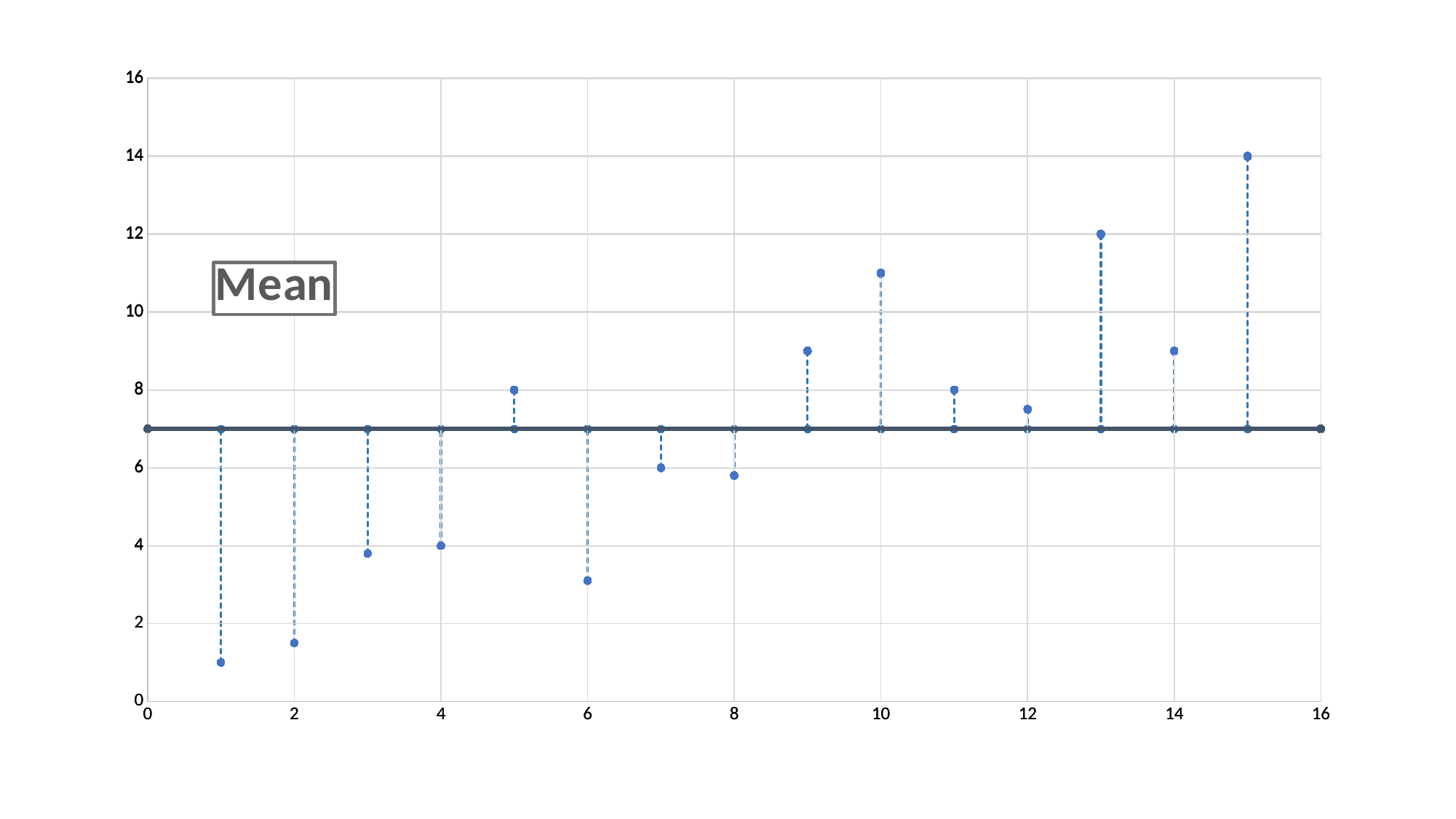
What is the y value of the point at x = 15? 14 What does the horizontal line across the chart represent, according to the label on the slide? Mean Is the y value of the point at x = 6 greater or less than 4? less What is the difference between the y values at x = 15 and x = 13? 2 Which point has the larger y value, the one at x = 13 or the one at x = 10? x = 13 What type of chart is shown on the slide? scatter chart What is the y value of the point at x = 13? 12 What is the y value of the point at x = 4? 4 What is the y value of the point at x = 5? 8 How many data points are plotted above the x axis (excluding the mean line)? 15 Do the plotted y values generally rise or fall as x increases? rise At which x value is the highest point plotted? 15